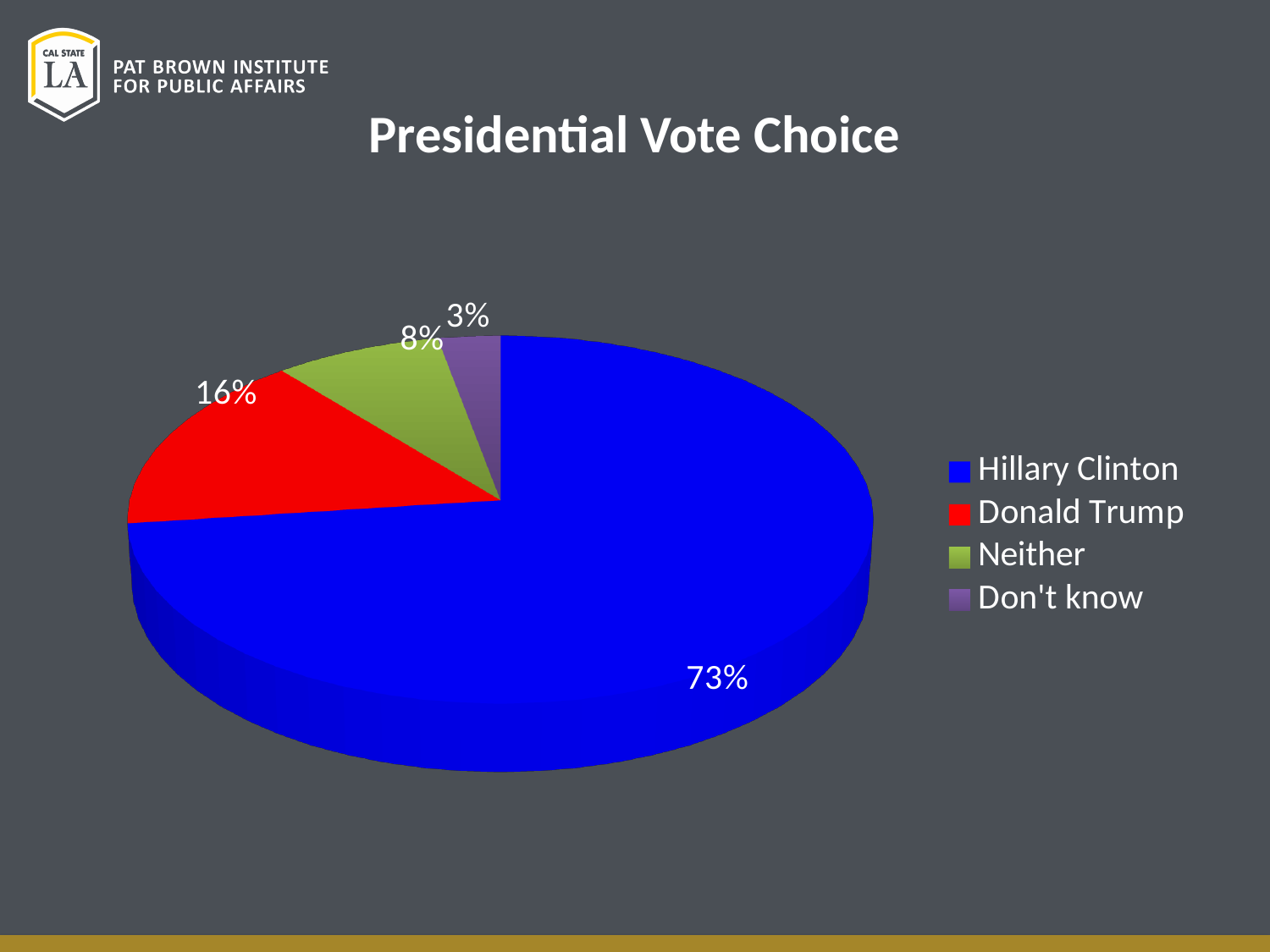
What colour is the Donald Trump slice? red What is the title of the chart? Presidential Vote Choice How many categories does the pie chart have? 4 What is the value for Donald Trump? 16% What is the value for Don't know? 3% What kind of chart is shown on the slide? pie chart Which category has the smallest slice? Don't know What share of the pie does Hillary Clinton have? 73% Which category has the largest slice? Hillary Clinton What is the difference between the Hillary Clinton and Donald Trump values? 57% What is the value for Neither? 8% Which is larger, the value for Neither or the value for Don't know? Neither